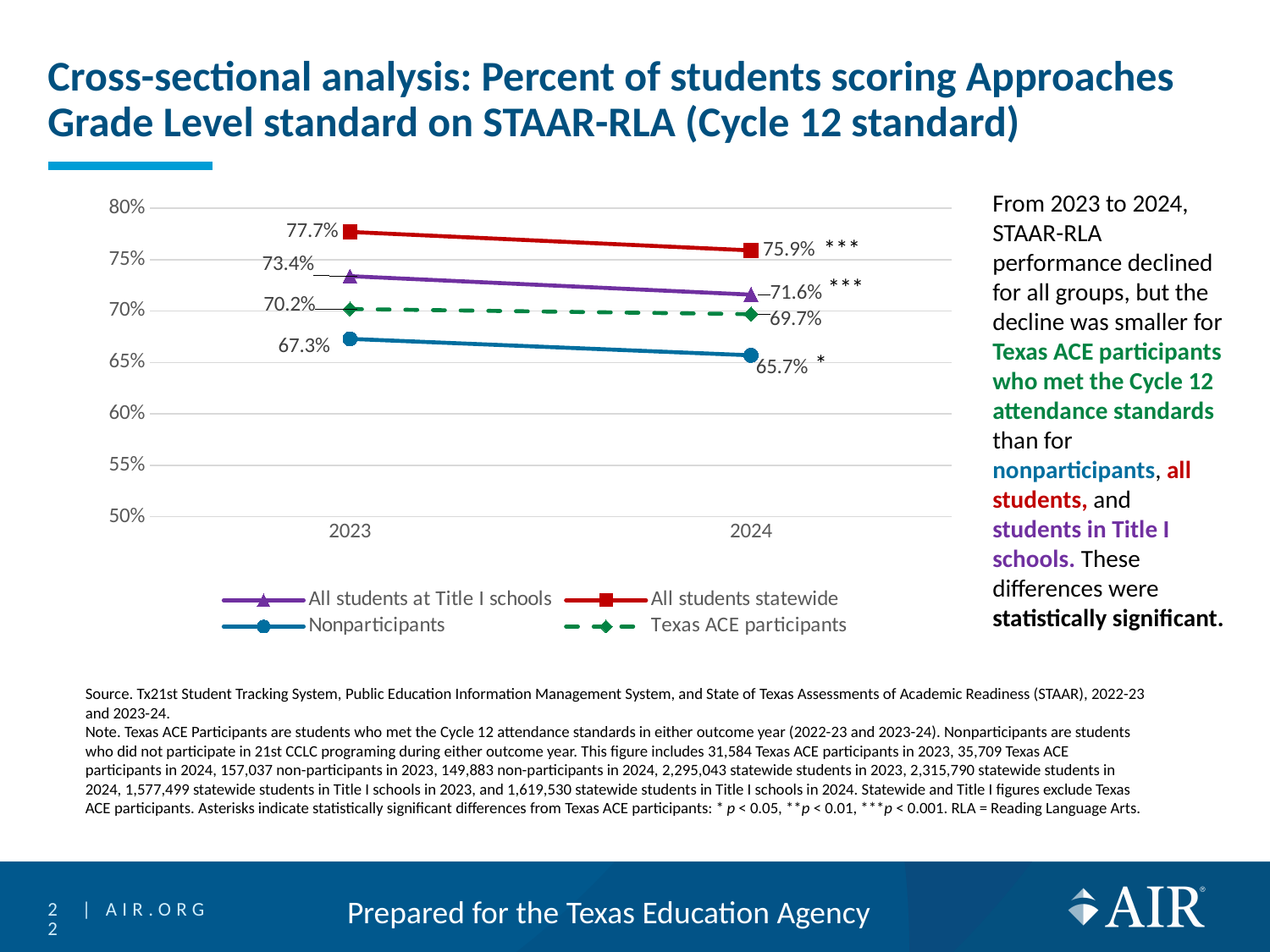
Which group had the highest value in 2024? All students statewide Did the value for Nonparticipants rise or fall from 2023 to 2024? Fall Which group had the lowest value in 2023? Nonparticipants What was the value for Texas ACE participants in 2024? 69.7% What is the difference between Texas ACE participants and Nonparticipants in 2024? 4.0 percentage points What kind of chart is shown on the slide? Line chart How many series does the legend list? 4 What percent of all students statewide scored Approaches Grade Level on STAAR-RLA in 2023? 77.7% What was the value for Nonparticipants in 2023? 67.3% Which was larger in 2023: All students at Title I schools or Texas ACE participants? All students at Title I schools What was the value for All students at Title I schools in 2024? 71.6% By how many percentage points did the value for All students statewide change from 2023 to 2024? 1.8 percentage points